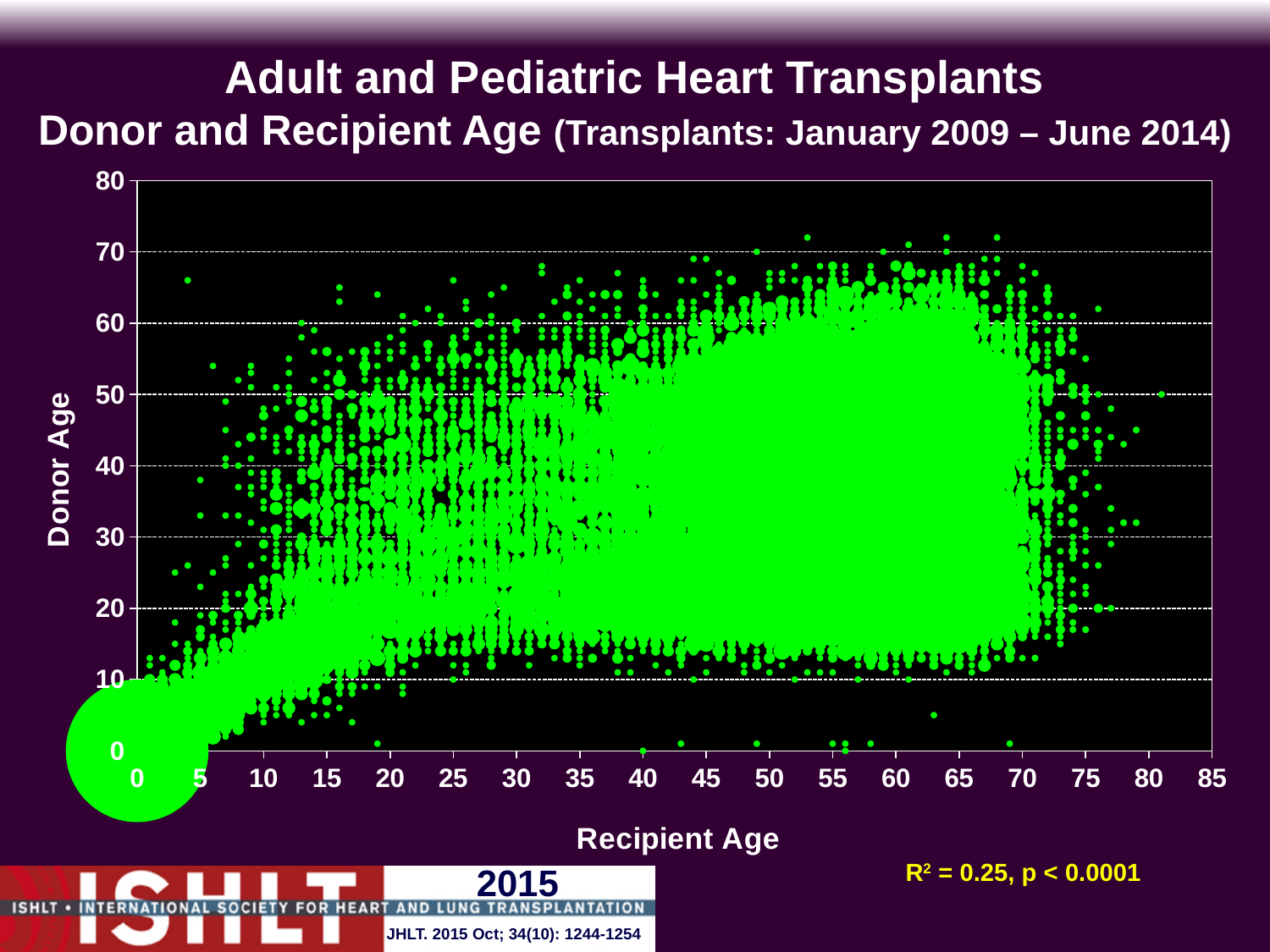
What kind of chart is shown on the slide? scatter (bubble) chart What variable is plotted on the y axis? Donor Age As recipient age increases along the x axis, do donor ages generally rise or fall? rise What variable is plotted on the x axis? Recipient Age What p-value is reported on the slide? p < 0.0001 What R² value is reported for the relationship between donor and recipient age? 0.25